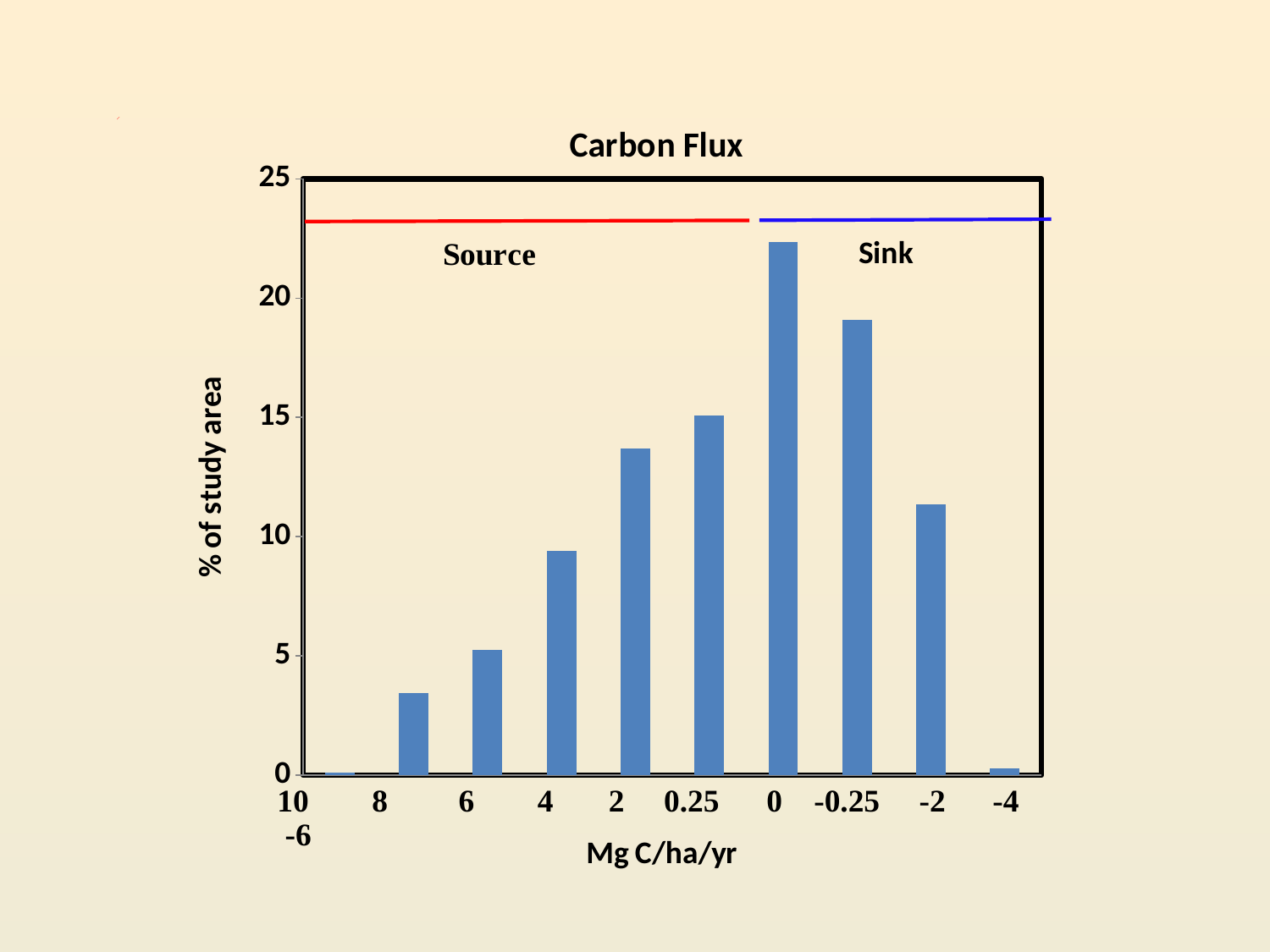
Which x-axis label is the tallest bar nearest to? 0 Is the bar nearest the x-axis label -2 greater or less than 10? greater Is the bar nearest the x-axis label 8 greater or less than 5? less Is the tallest bar in the chart greater or less than 20% of study area? greater Which is taller: the bar nearest the x-axis label 0 or the bar nearest the x-axis label -0.25? the bar nearest 0 What is the y-axis title of the chart? % of study area Do the bars rise or fall moving from the left edge of the chart toward the x-axis label 0? rise What is the title of the chart? Carbon Flux What type of chart is shown on the slide? bar chart How many bars are plotted in the chart? 10